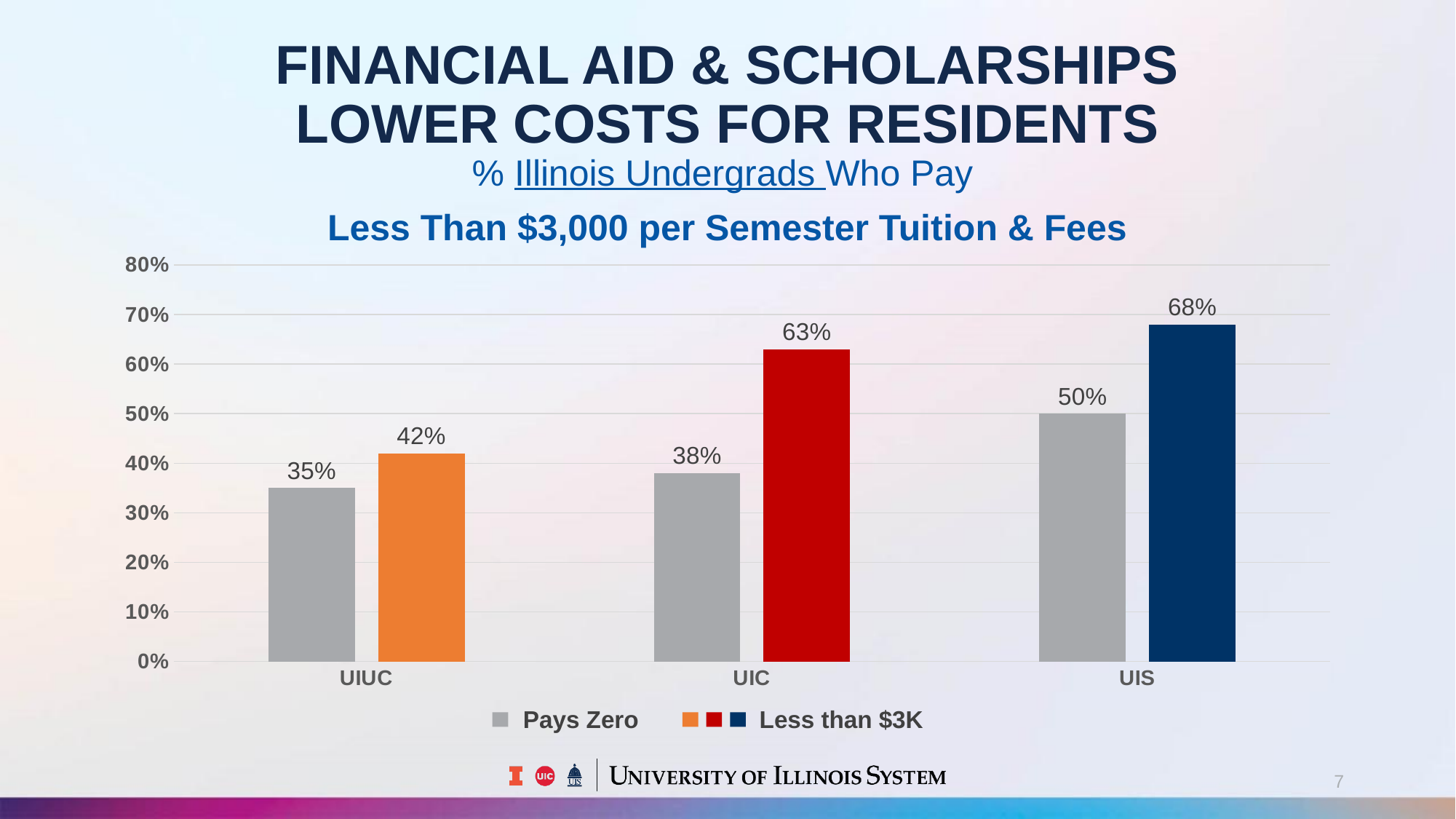
What is the 'Pays Zero' value for UIS? 50% Which campus has the highest 'Less than $3K' value? UIS What is the difference between the 'Less than $3K' values for UIS and UIUC? 26% What percentage of Illinois undergrads at UIUC pay zero? 35% Which is larger: the 'Pays Zero' value for UIC or for UIS? UIS What kind of chart is shown on the slide? bar chart How many campuses are shown on the x axis? 3 Which campus has the lowest 'Pays Zero' value? UIUC How many series does the legend list? 2 What is the difference between the 'Less than $3K' and 'Pays Zero' values at UIC? 25% Is the 'Less than $3K' value for UIUC greater or less than 50%? less What is the value for 'Less than $3K' at UIC? 63%